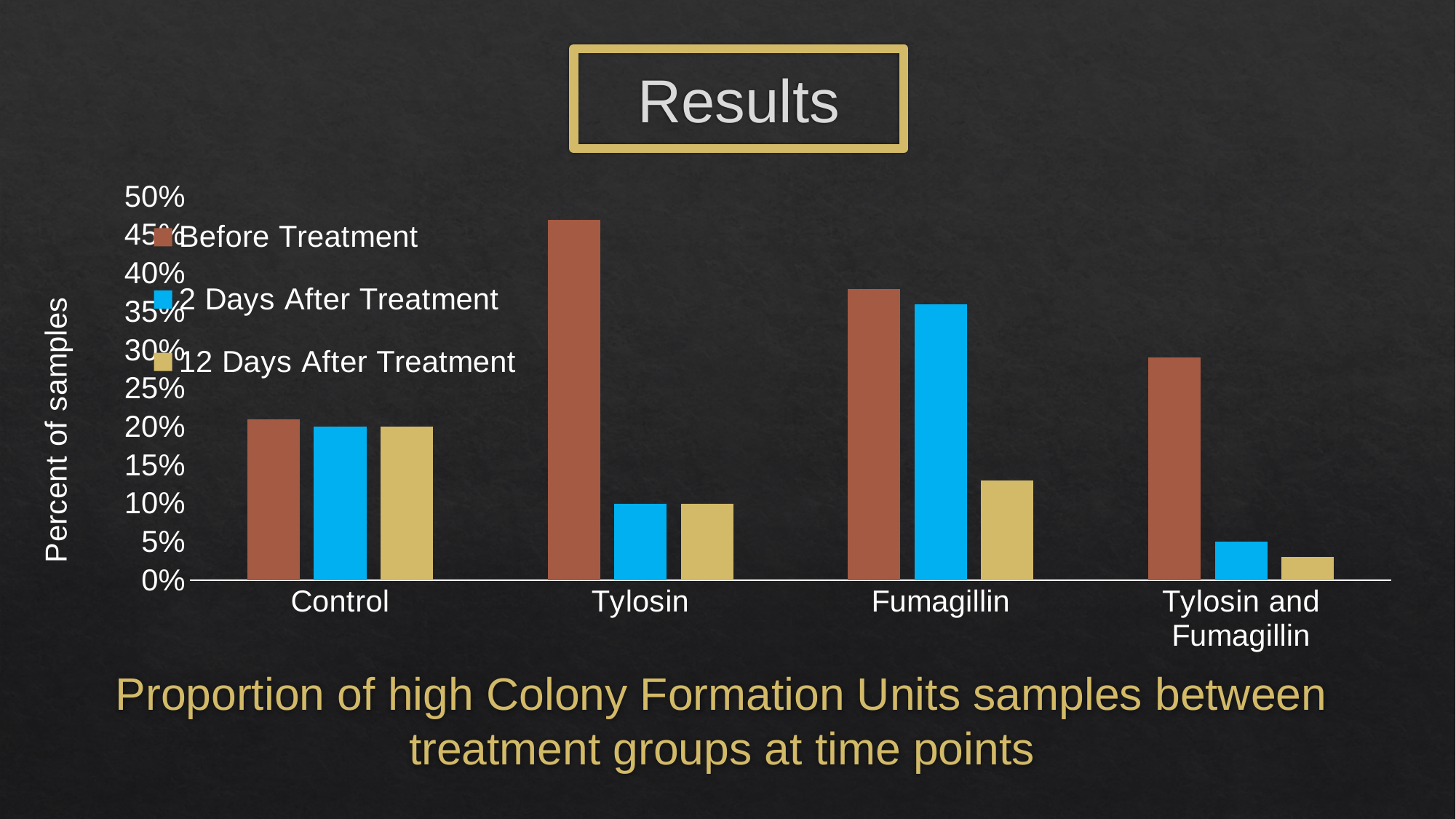
How many series does the legend list? 3 What is the title of the y axis? Percent of samples How many treatment groups are shown on the x axis? 4 Is the Before Treatment value for Tylosin greater or less than 40%? greater What kind of chart is shown on the slide? bar chart Which treatment group has the highest 2 Days After Treatment value? Fumagillin Do the values for Tylosin and Fumagillin rise or fall from Before Treatment to 12 Days After Treatment? fall Which treatment group has the highest Before Treatment value? Tylosin Is the Before Treatment value for Tylosin and Fumagillin greater or less than 25%? greater Which treatment group has the lowest 12 Days After Treatment value? Tylosin and Fumagillin Which is larger: the Before Treatment value for Fumagillin or the Before Treatment value for Tylosin and Fumagillin? Fumagillin Is the 12 Days After Treatment value for Fumagillin greater or less than 15%? less